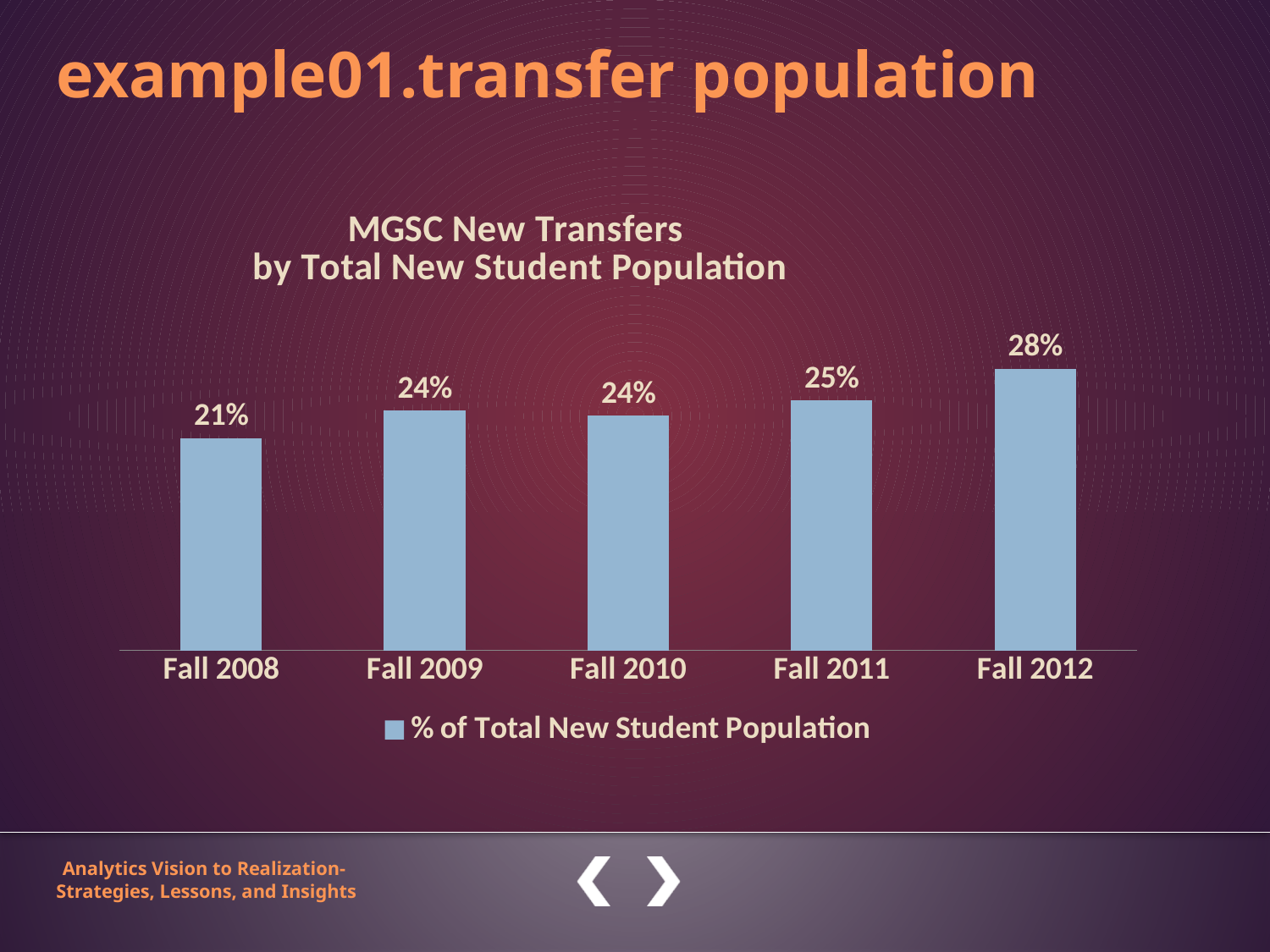
What is the value for Fall 2008? 21% What kind of chart is shown? bar chart What is the value for Fall 2012? 28% What is the value for Fall 2011? 25% Which category has the highest value? Fall 2012 Which category has the lowest value? Fall 2008 What is the title of the chart? MGSC New Transfers by Total New Student Population What is the difference between the values for Fall 2011 and Fall 2009? 1% How many categories are shown on the x axis? 5 What is the difference between the values for Fall 2012 and Fall 2008? 7% Which is larger, the value for Fall 2011 or the value for Fall 2008? Fall 2011 How many series does the legend list? 1